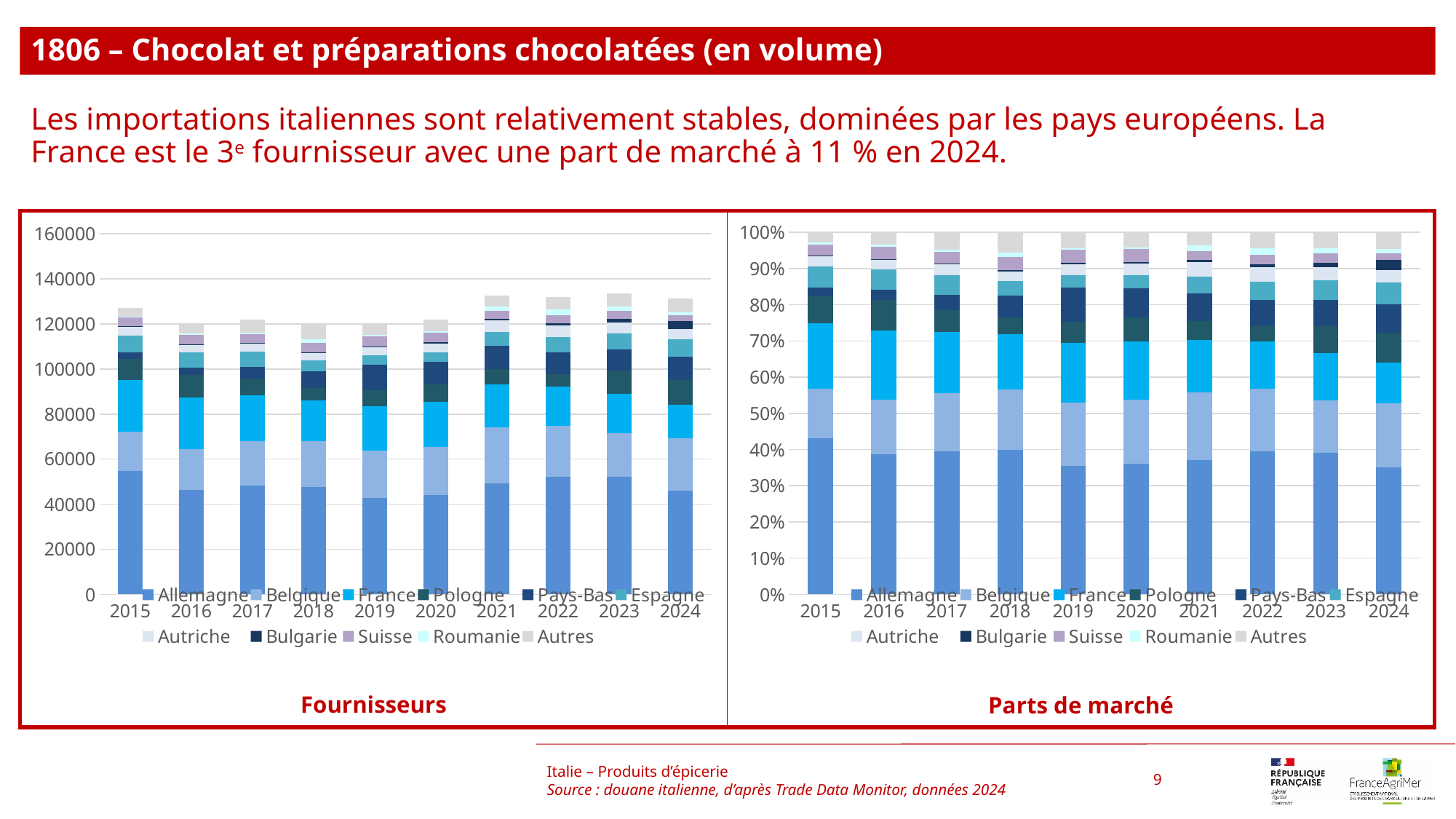
In the 'Fournisseurs' chart, is the total height of the 2021 bar greater or less than 120000? greater How many years are shown on the x axis of the 'Parts de marché' chart? 10 What is the title printed below the right-hand chart? Parts de marché Which series is listed first in the legend of the 'Parts de marché' chart? Allemagne In the 'Parts de marché' chart, which is larger: the share for Allemagne in 2015 or in 2024? 2015 How many series does the legend of the 'Fournisseurs' chart list? 11 What kind of chart is the 'Fournisseurs' chart on the left? bar chart In the 'Fournisseurs' chart, is the total height of the 2015 bar greater or less than 120000? greater In the 'Parts de marché' chart, is the share for Allemagne in 2015 greater or less than 40%? greater In the 'Fournisseurs' chart, which is larger: the value for Allemagne in 2015 or in 2016? 2015